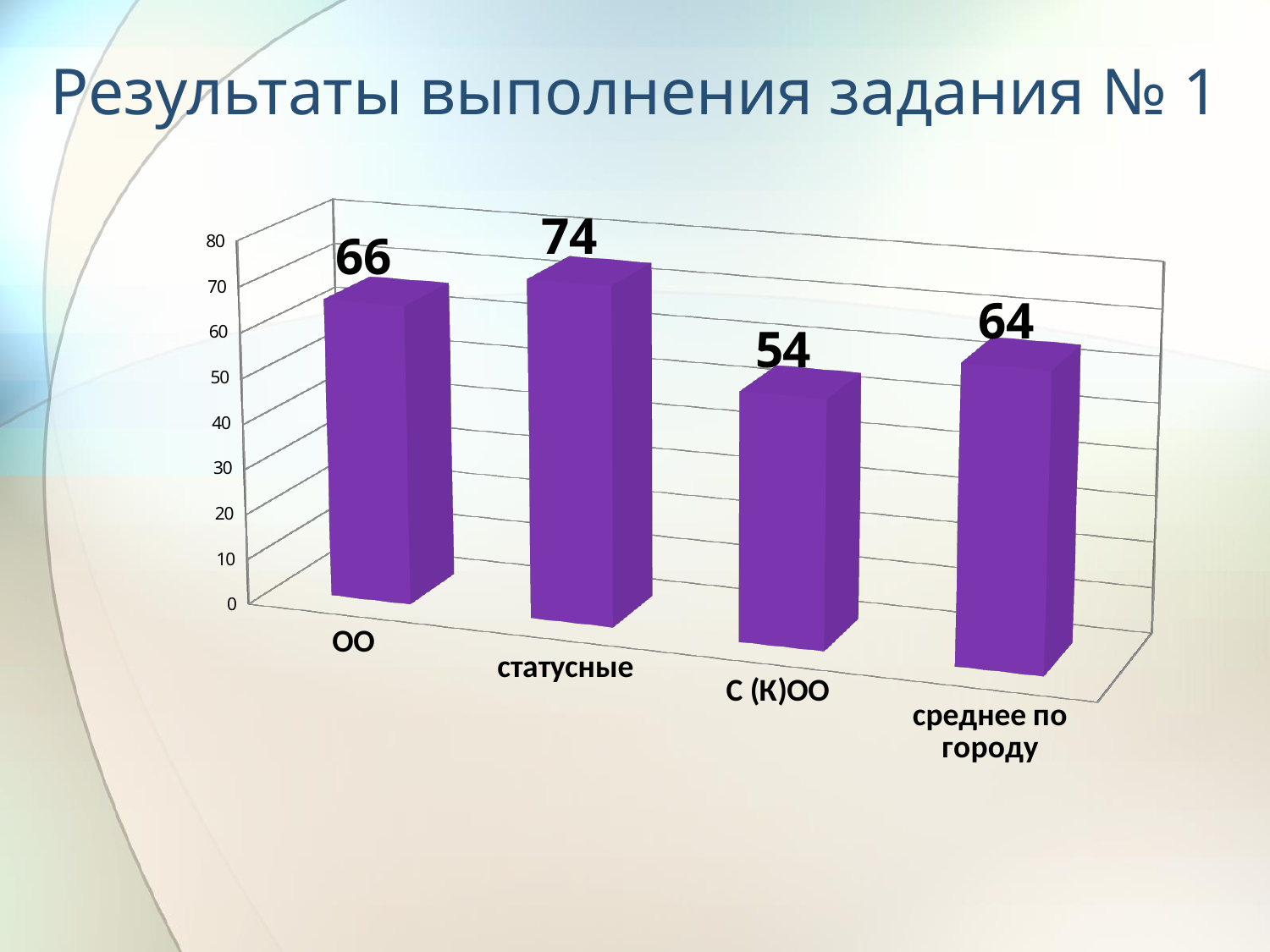
What is the value for С (К)ОО? 54 What kind of chart is shown on the slide? bar chart How many categories are shown on the chart? 4 Which category has the highest value? статусные Which is larger, the value for ОО or the value for С (К)ОО? ОО What is the difference between the values for статусные and С (К)ОО? 20 What is the value for статусные? 74 What is the difference between the values for ОО and среднее по городу? 2 What is the value for среднее по городу? 64 What is the title of the slide? Результаты выполнения задания № 1 Which category has the lowest value? С (К)ОО What is the value for ОО? 66